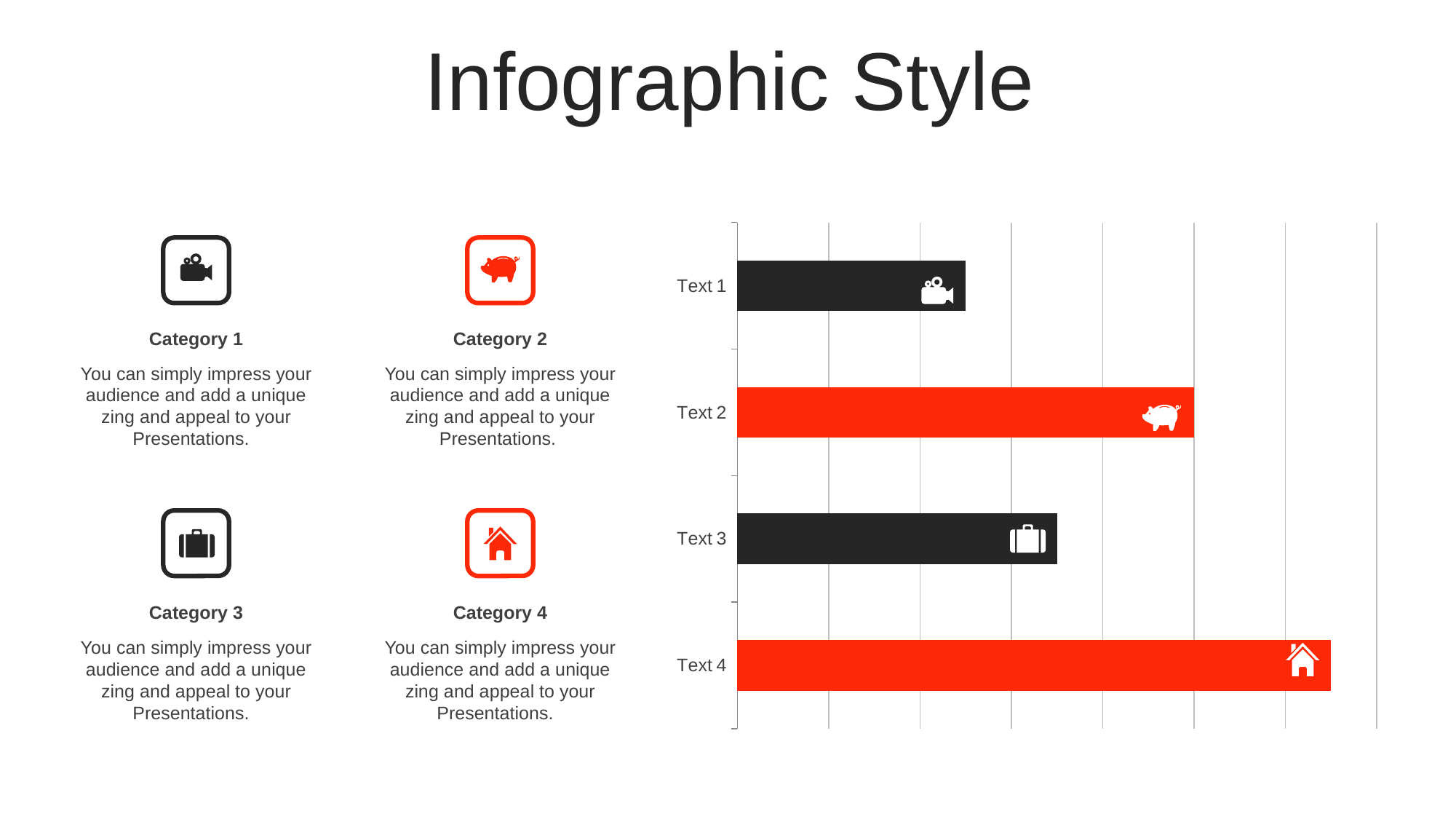
What colour is the bar for Text 2? red Which category has the longest bar in the chart? Text 4 Which category has the shortest bar in the chart? Text 1 Which bar is longer, Text 2 or Text 4? Text 4 Are the bars in the chart drawn horizontally or vertically? horizontally How many categories does the bar chart show? 4 Which bar is longer, Text 2 or Text 3? Text 2 Which bar is longer, Text 1 or Text 3? Text 3 What kind of chart is shown on the slide? bar chart